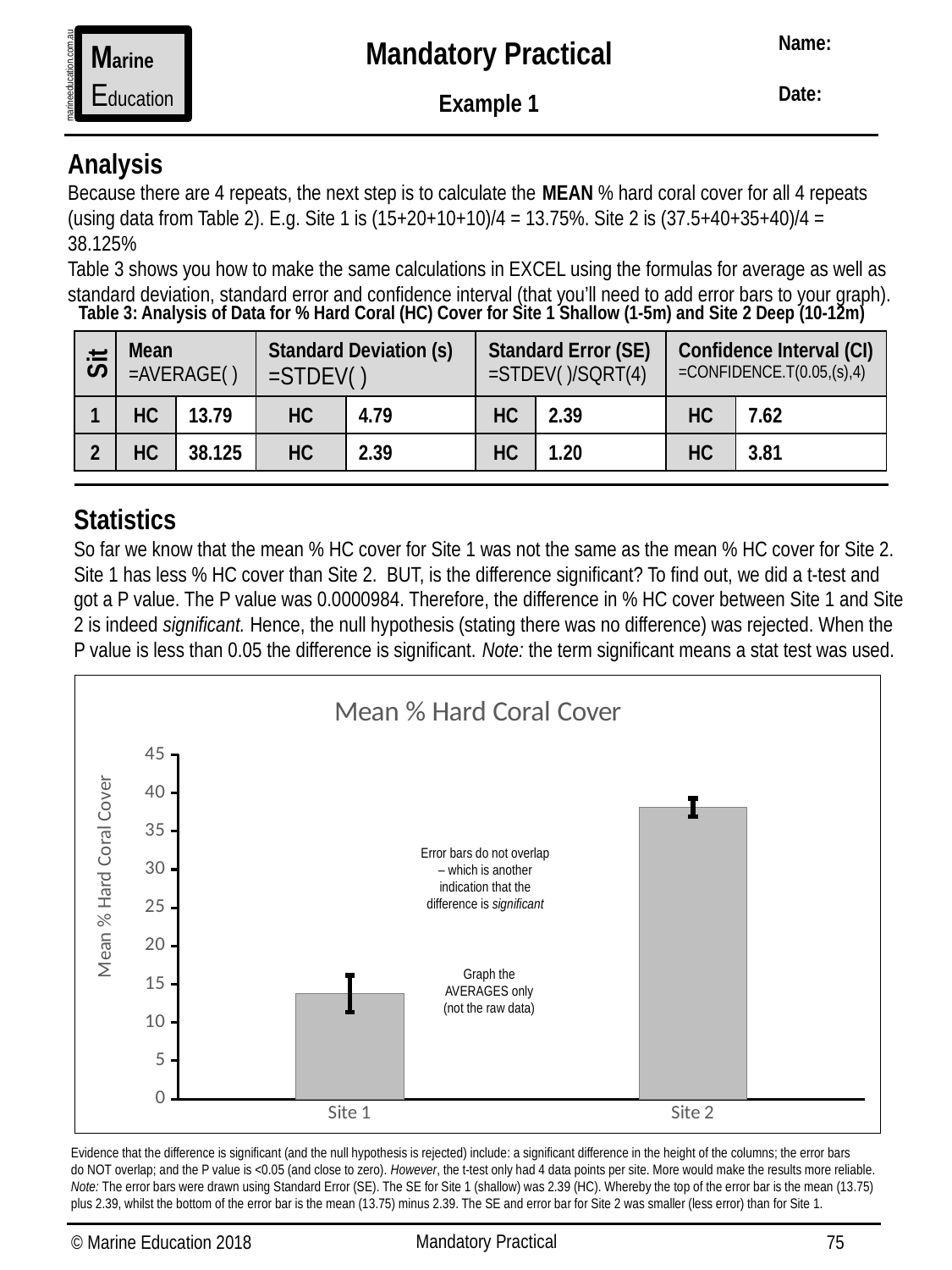
Which bar is taller, Site 1 or Site 2? Site 2 Is the value for Site 1 greater or less than 10? greater What is the title of the chart? Mean % Hard Coral Cover Which site has the lowest mean % hard coral cover on the chart? Site 1 Do the bar values rise or fall from Site 1 to Site 2? rise Is the value for Site 2 greater or less than 35? greater Is the value for Site 1 greater or less than 15? less Which site has the highest mean % hard coral cover on the chart? Site 2 How many sites (categories) are plotted on the chart? 2 What is the label on the vertical axis of the chart? Mean % Hard Coral Cover What kind of chart is shown on the slide? bar chart